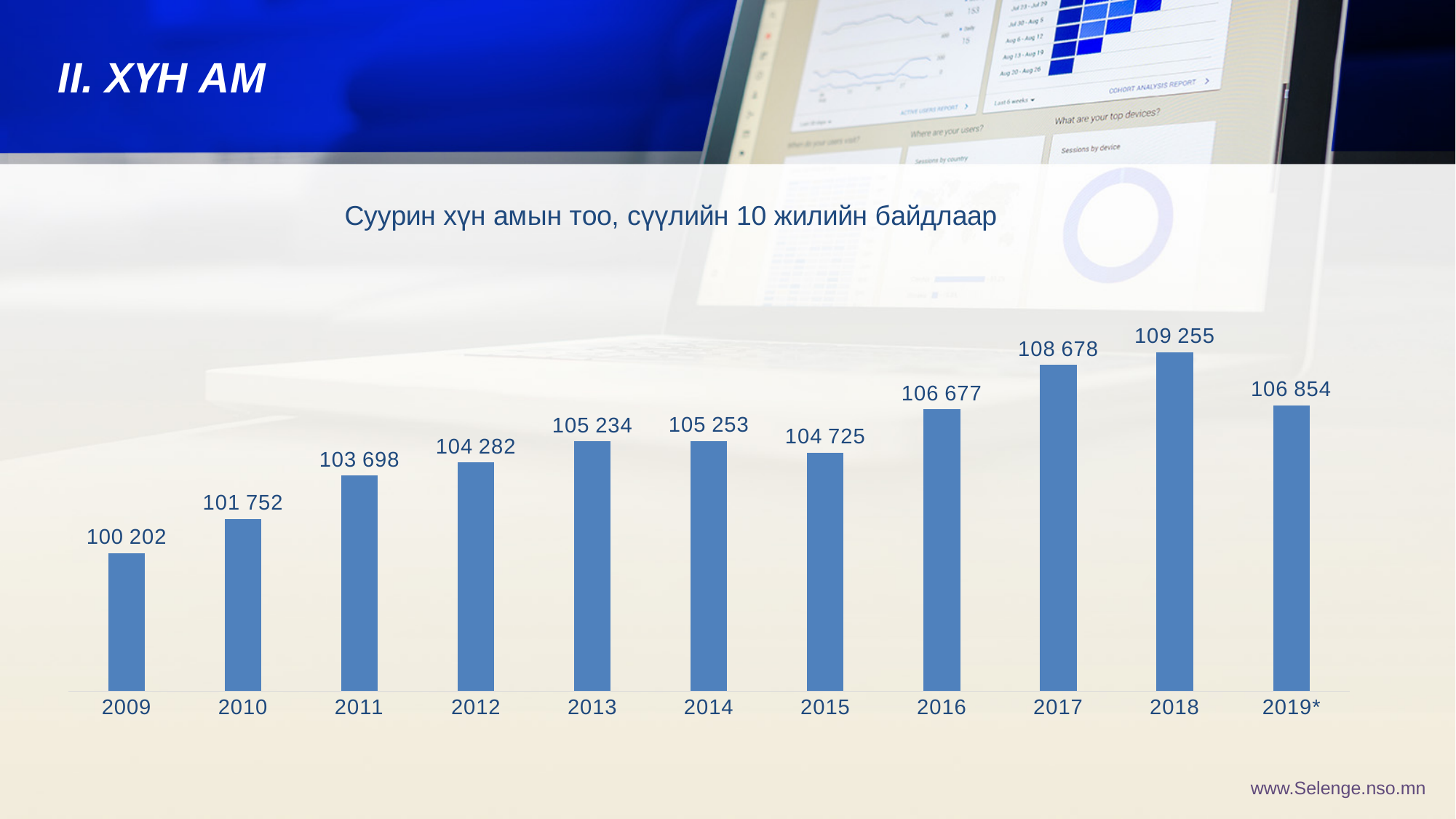
What is the value for 2019*? 106 854 How many years are shown on the x axis? 11 Which year has the highest value? 2018 What is the difference between the values for 2018 and 2019*? 2 401 What is the value for 2016? 106 677 What is the value for 2009? 100 202 What is the title of the chart? Суурин хүн амын тоо, сүүлийн 10 жилийн байдлаар Do the values generally rise or fall from 2009 to 2018? rise What is the difference between the values for 2018 and 2017? 577 Which year has the lowest value? 2009 What kind of chart is this? bar chart Which is larger, the value for 2015 or the value for 2016? 2016